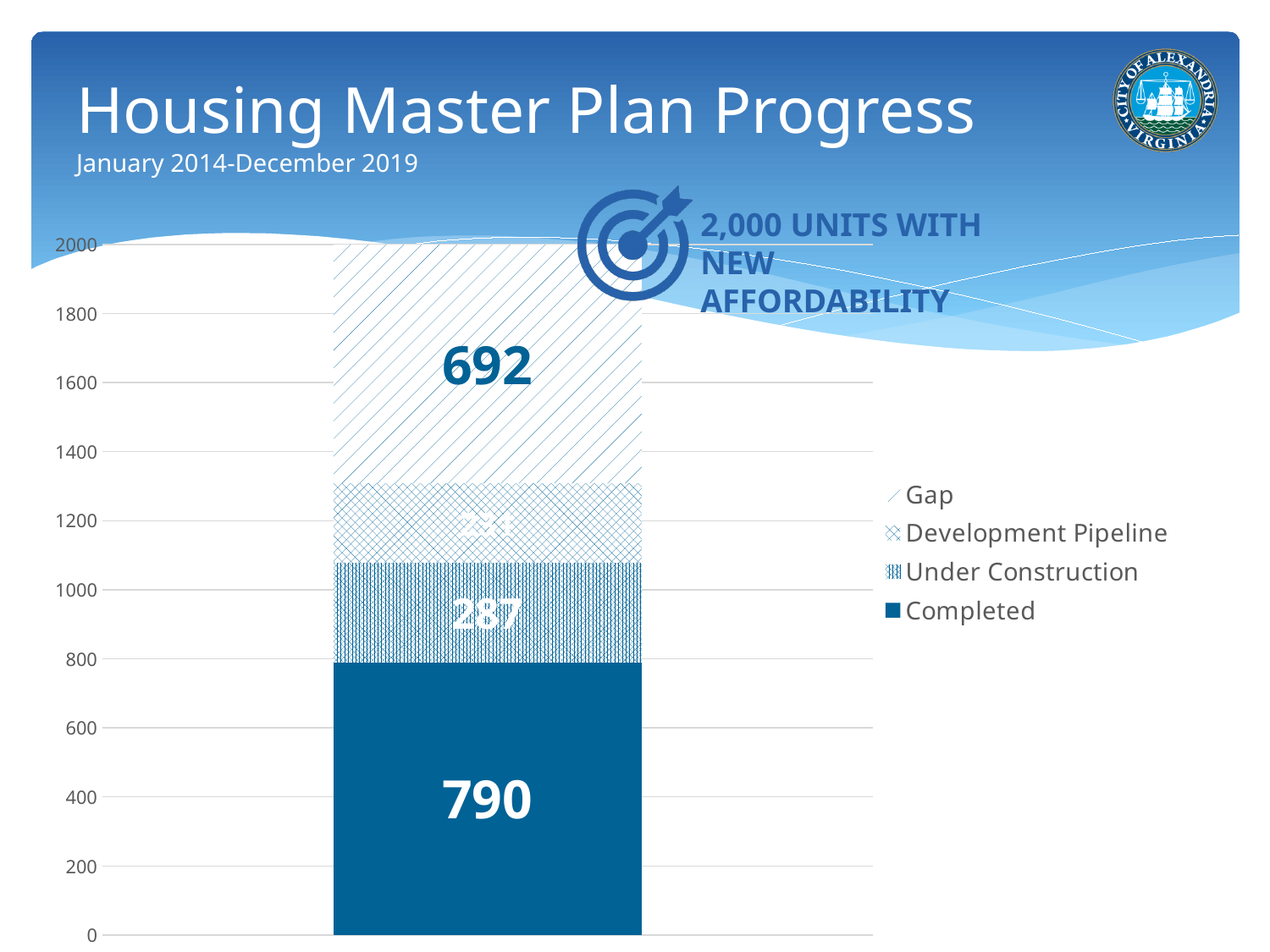
How many series does the legend list? 4 What is the title of the slide containing the chart? Housing Master Plan Progress What is the value of the Gap segment in the stacked bar? 692 What is the difference between the Completed value and the Gap value? 98 Which is larger, the Gap segment or the Under Construction segment? Gap Which is larger, the Completed segment or the Gap segment? Completed What kind of chart is shown on the slide? Stacked bar chart How many bars are plotted in the chart? 1 What is the difference between the Completed value and the Under Construction value? 503 What is the value of the Under Construction segment in the stacked bar? 287 Which segment of the stacked bar has the largest value? Completed What is the value of the Completed segment in the stacked bar? 790